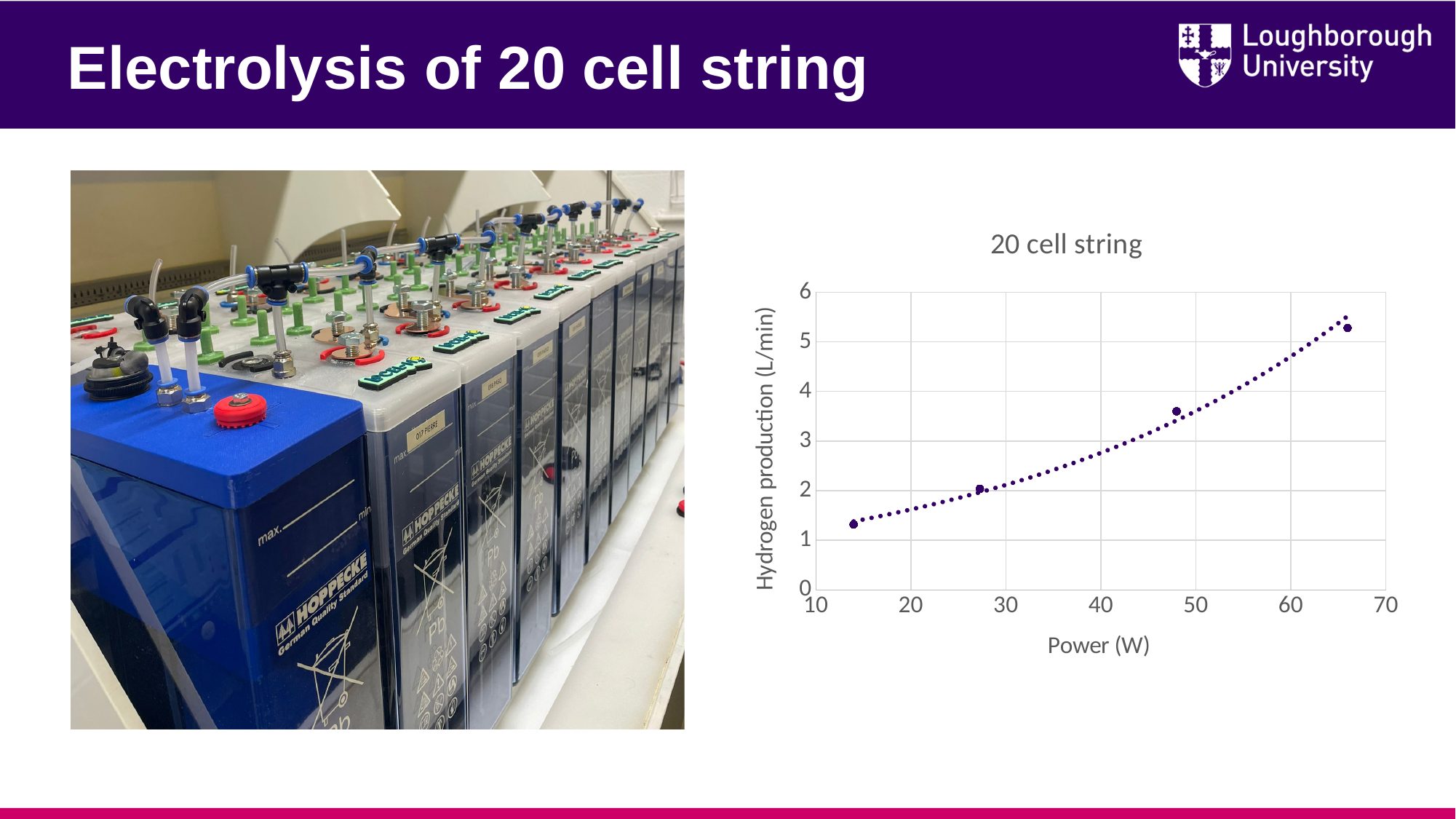
What kind of chart is shown on the slide? scatter chart Is the hydrogen production at the data point near 48 W greater or less than 3 L/min? greater What is the title of the chart? 20 cell string Is the hydrogen production at the highest-power data point (around 66 W) greater or less than 5 L/min? greater What is the maximum value shown on the y axis of the chart? 6 Is the power of the lowest data point greater or less than 20 W? less How many data points are plotted on the chart (excluding the dotted trendline)? 4 What is the label of the x axis of the chart? Power (W) Which data point has the highest hydrogen production: the one near 48 W or the one near 66 W? the one near 66 W Does hydrogen production rise or fall as power increases along the x axis? rise